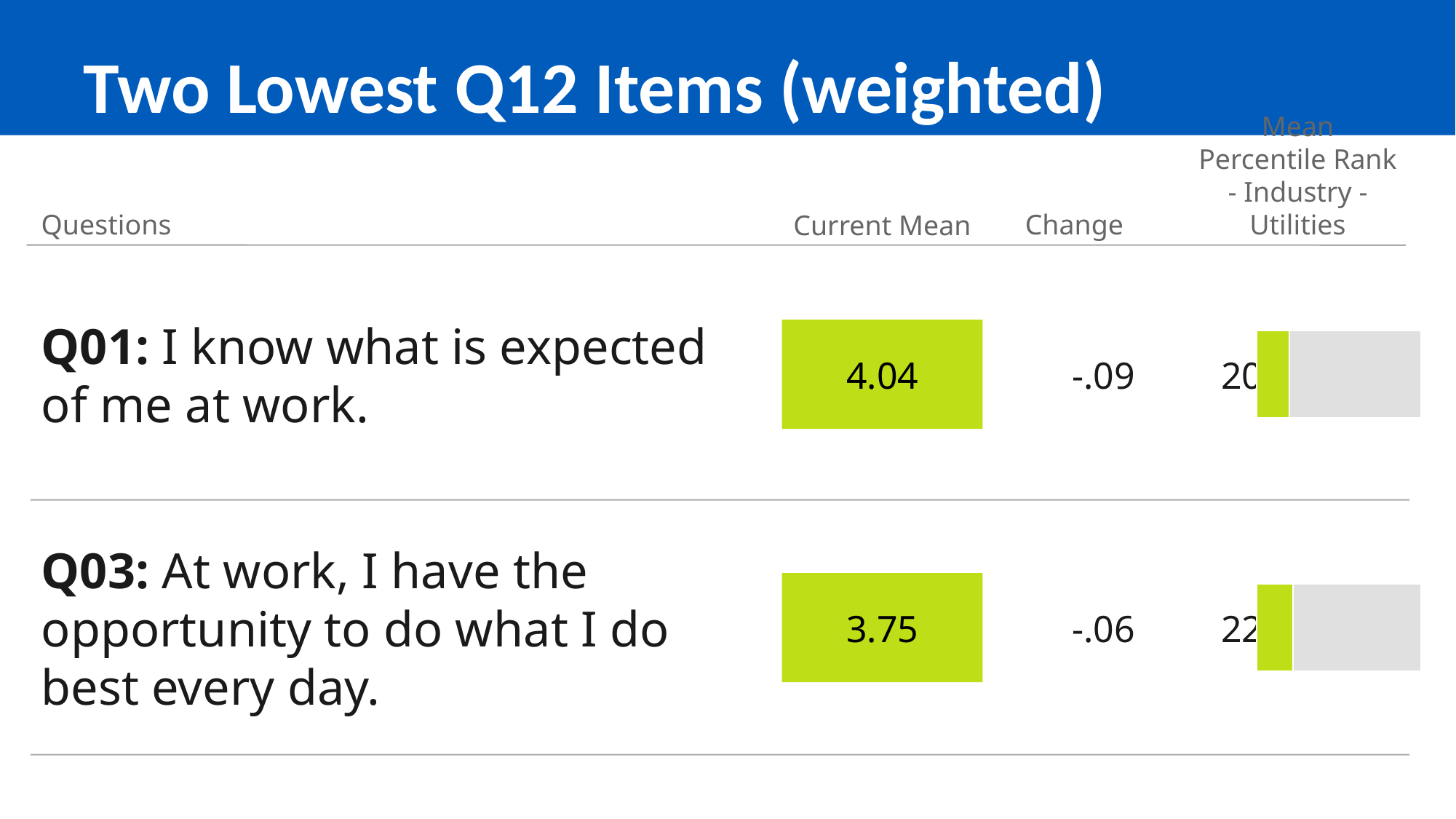
Which item has the higher Current Mean, Q01 or Q03? Q01 What is the difference between the Current Mean of Q01 and the Current Mean of Q03? 0.29 What colour are the Current Mean bars on the slide? Green Which item shows the larger decline in the Change column, Q01 or Q03? Q01 What is the Change value shown for Q01? -.09 Which item has the lowest Current Mean on the slide? Q03 What is the Current Mean for Q03 (At work, I have the opportunity to do what I do best every day)? 3.75 What is the Current Mean for Q01 (I know what is expected of me at work)? 4.04 What is the title of the slide? Two Lowest Q12 Items (weighted) What is the Change value shown for Q03? -.06 Is the Current Mean for Q03 greater or less than 4? less How many Q12 items are shown on the slide? 2